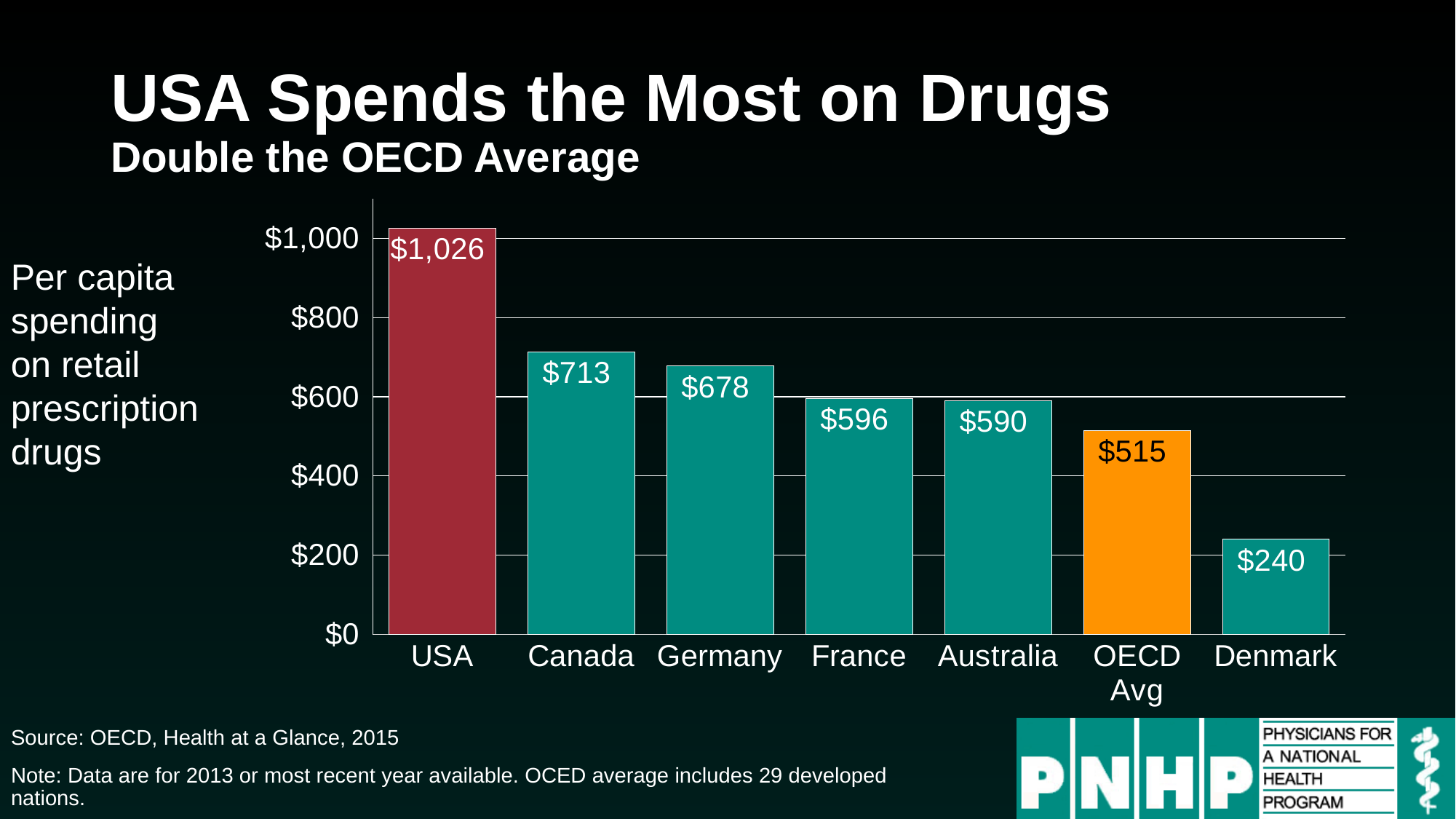
Is the value for Australia greater or less than $400? greater What colour is the USA bar? Red Which has a higher per capita spending, France or Denmark? France How many categories (bars) are shown in the chart? 7 What is the per capita spending shown for Germany? $678 What is the value shown for the OECD Avg bar? $515 What is the difference between Canada's and Germany's per capita spending? $35 Which category has the lowest value in the chart? Denmark What kind of chart is shown on the slide? Bar chart What is the difference between the USA value and the OECD Avg value? $511 What is the per capita spending on retail prescription drugs for Canada? $713 Which country has the highest per capita spending on retail prescription drugs? USA